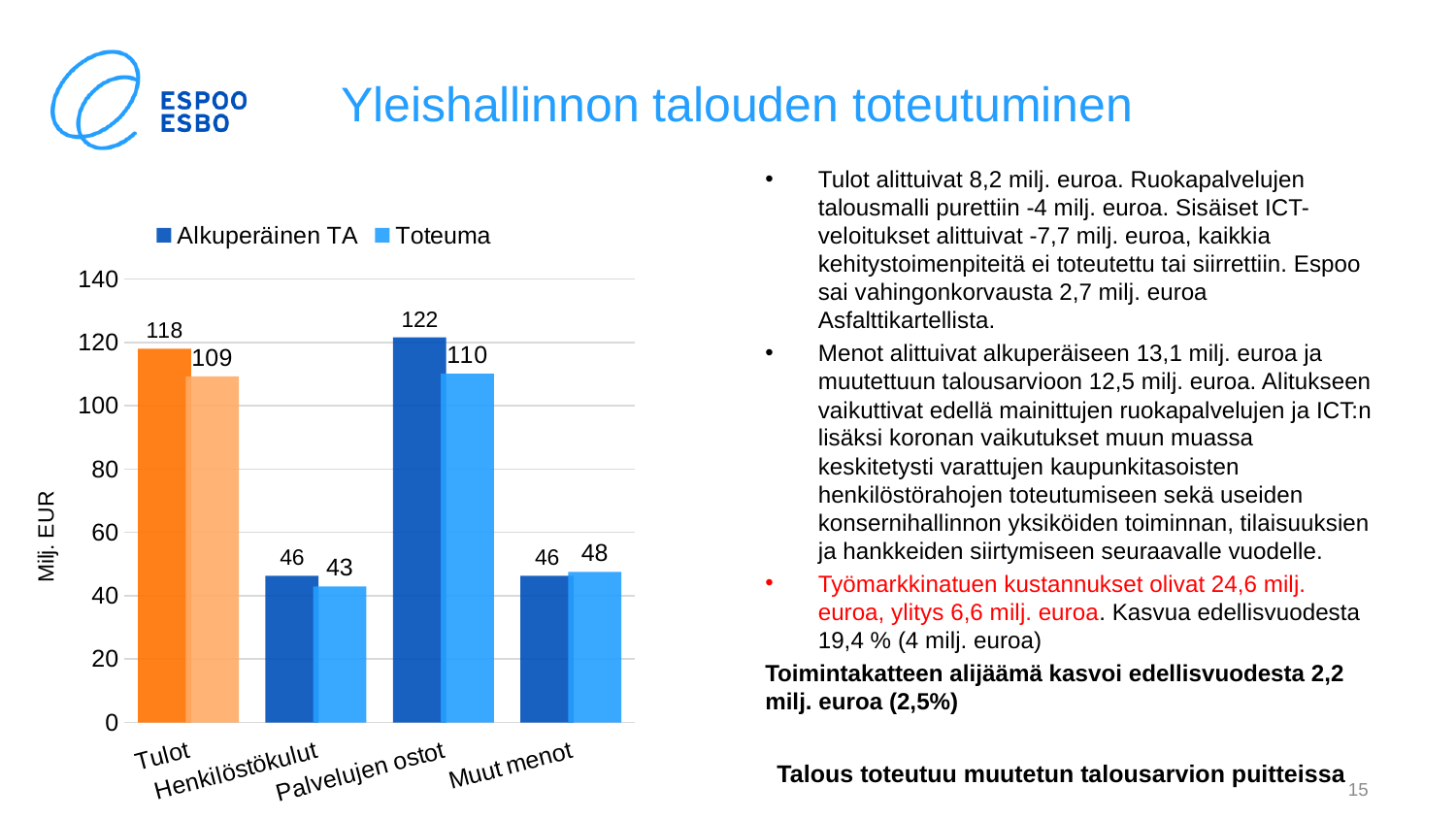
What is the Toteuma value for Henkilöstökulut? 43 What is the Alkuperäinen TA value for Tulot? 118 Which category has the highest Alkuperäinen TA value? Palvelujen ostot What is the Toteuma value for Palvelujen ostot? 110 What is the label of the y axis? Milj. EUR How many categories are shown on the x axis? 4 Which category has the lowest Toteuma value? Henkilöstökulut How many series does the legend list? 2 For Muut menot, which is larger: Alkuperäinen TA or Toteuma? Toteuma What kind of chart is shown on the slide? Bar chart What is the difference between the Alkuperäinen TA and Toteuma values for Tulot? 9 What is the difference between the Alkuperäinen TA and Toteuma values for Palvelujen ostot? 12